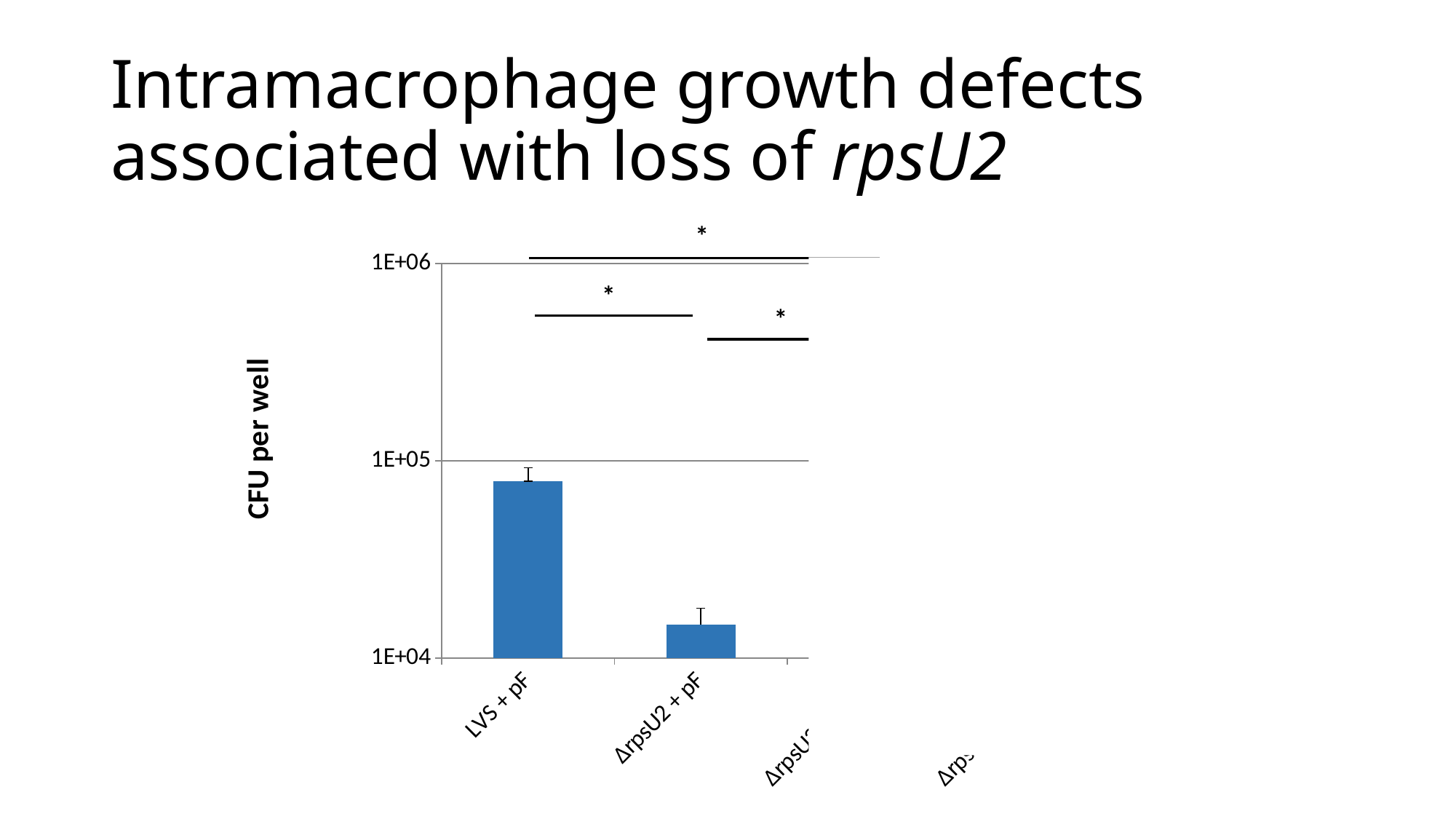
Is the value for LVS + pF greater or less than 1E+04? greater Is the value for ΔrpsU2 + pF greater or less than 1E+05? less What kind of chart is shown on the slide? bar chart Of the bars labelled LVS + pF and ΔrpsU2 + pF, which has the lower value? ΔrpsU2 + pF What is the y-axis title of the chart? CFU per well Is the value for ΔrpsU2 + pF greater or less than 1E+04? greater Which bar is taller, LVS + pF or ΔrpsU2 + pF? LVS + pF What is the highest tick value shown on the y axis? 1E+06